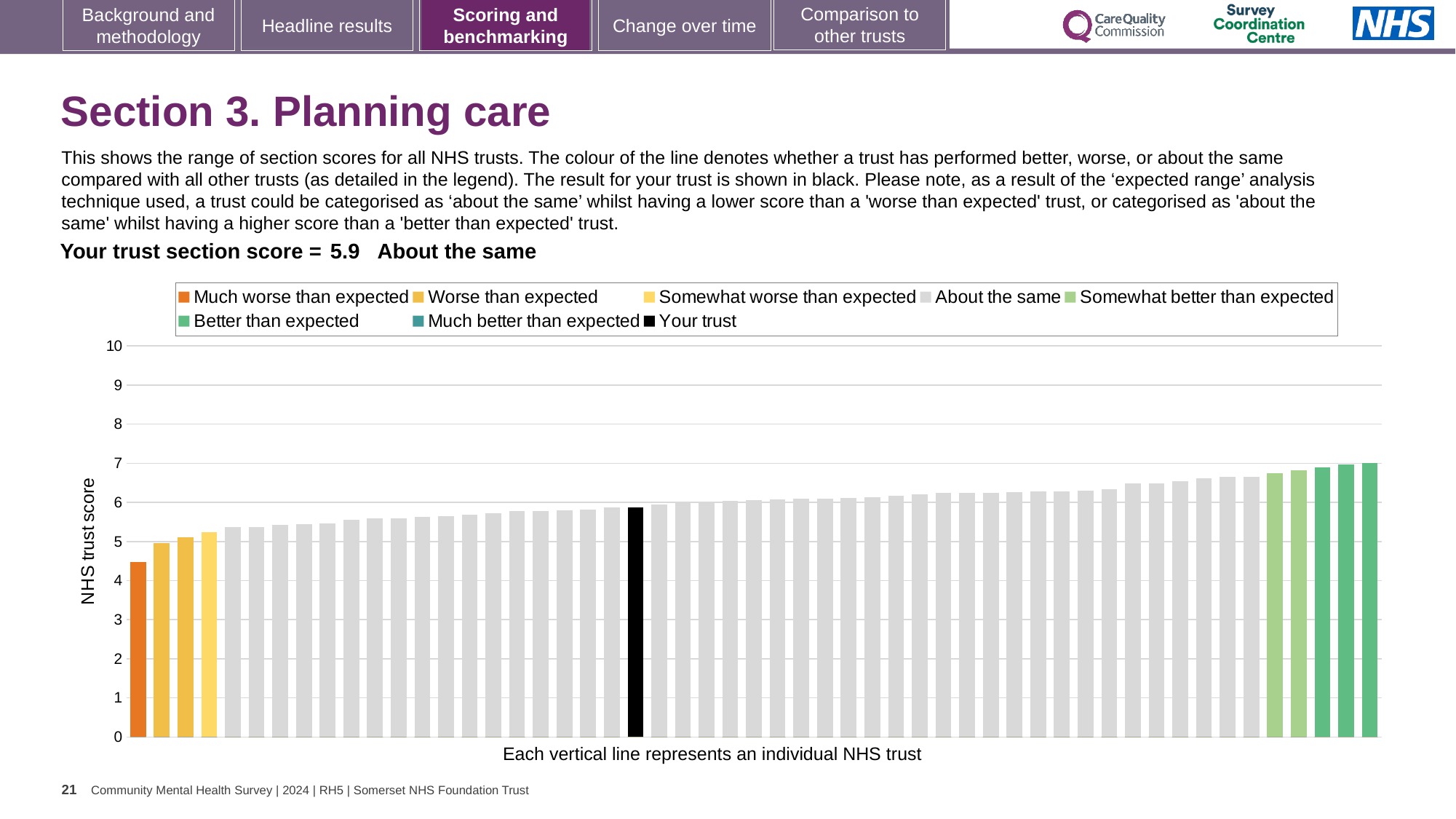
Do the NHS trust scores rise or fall from left to right across the chart? Rise Is the value of the highest bar on the chart greater or less than 8? less Which legend category does the lowest-scoring trust on the chart belong to? Much worse than expected Is the value of the black bar (your trust) greater or less than 5? greater Is the value of the lowest bar (the orange one) greater or less than 5? less Which legend category does the highest-scoring trust on the chart belong to? Better than expected What kind of chart is shown on the slide? Bar chart How many entries does the chart legend list? 8 What is your trust's section score shown on the slide? 5.9 How many bars on the chart are coloured orange (Much worse than expected)? 1 What category is your trust placed in for Section 3 Planning care? About the same What is the label on the vertical axis of the chart? NHS trust score